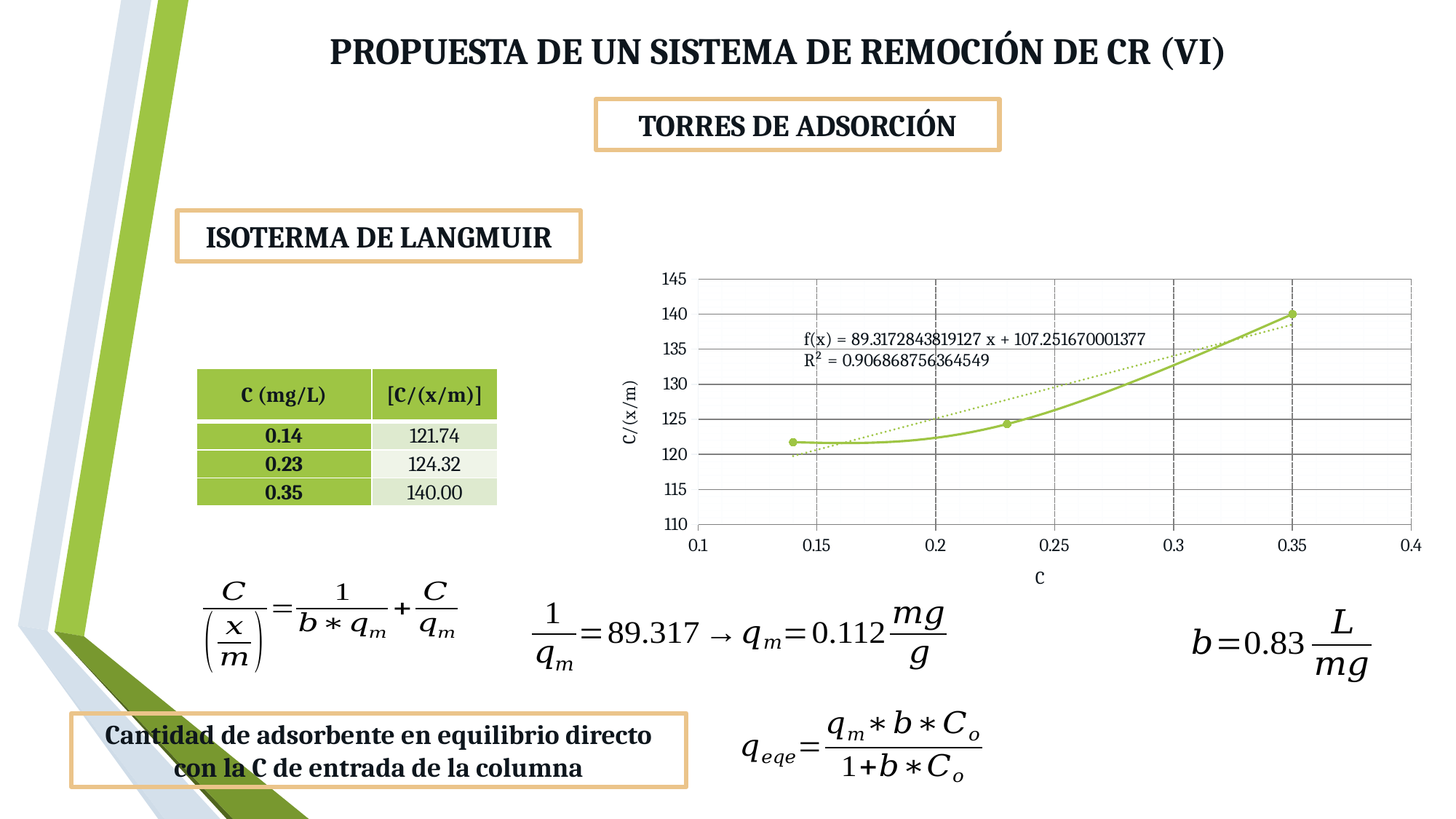
According to the table on the slide, what is the value of C/(x/m) at C = 0.35 mg/L? 140.00 At which value of C is C/(x/m) lowest on the chart? 0.14 Do the values of C/(x/m) rise or fall as C increases along the x axis? rise Is the value of C/(x/m) at C = 0.14 greater or less than 125? less Using the table values, what is the difference between C/(x/m) at C = 0.35 and at C = 0.14? 18.26 How many data points are plotted on the chart? 3 What kind of chart is shown on the slide? line chart Is the value of C/(x/m) at C = 0.35 greater or less than 135? greater Which has the larger C/(x/m) value on the chart, C = 0.23 or C = 0.14? 0.23 What R² value is printed on the chart for the trendline? 0.906868756364549 At which value of C is C/(x/m) highest on the chart? 0.35 What is the label of the y axis of the chart? C/(x/m)